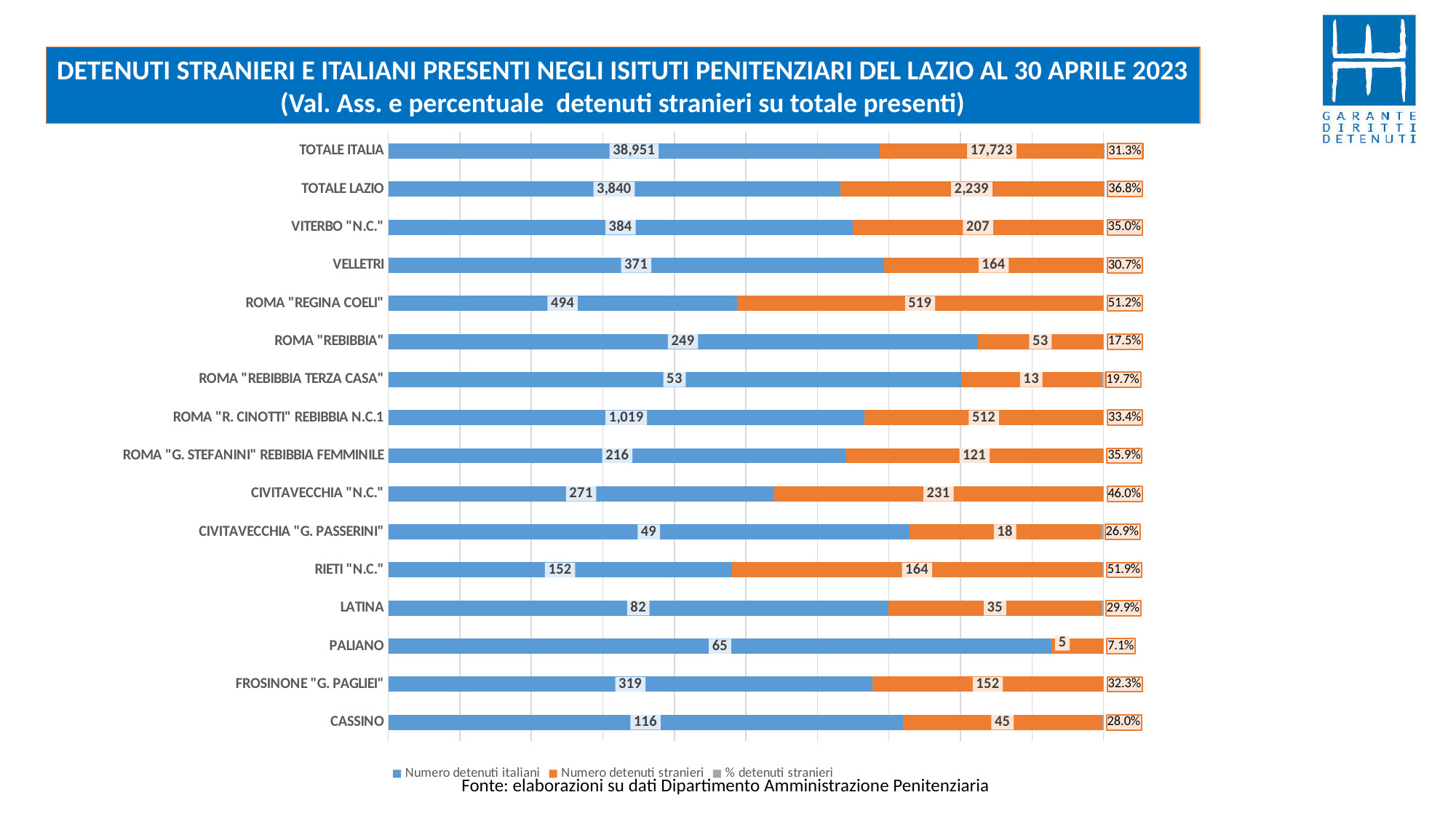
Which category has the highest percentage of foreign detainees? RIETI "N.C." What colour represents the series Numero detenuti stranieri? Orange What kind of chart is shown on the slide? Stacked bar chart Which is larger at CIVITAVECCHIA "N.C.": the number of Italian detainees or the number of foreign detainees? Number of Italian detainees (271) What is the total number of detainees (Italian plus foreign) at CASSINO? 161 What is the number of Italian detainees (Numero detenuti italiani) for TOTALE LAZIO? 3,840 What percentage of foreign detainees (% detenuti stranieri) is shown for RIETI "N.C."? 51.9% How many series does the legend list? 3 Which category has the lowest percentage of foreign detainees? PALIANO How many categories (rows) are shown in the chart? 16 What is the number of foreign detainees (Numero detenuti stranieri) for ROMA "REGINA COELI"? 519 What is the difference between the number of Italian detainees and the number of foreign detainees at VITERBO "N.C."? 177